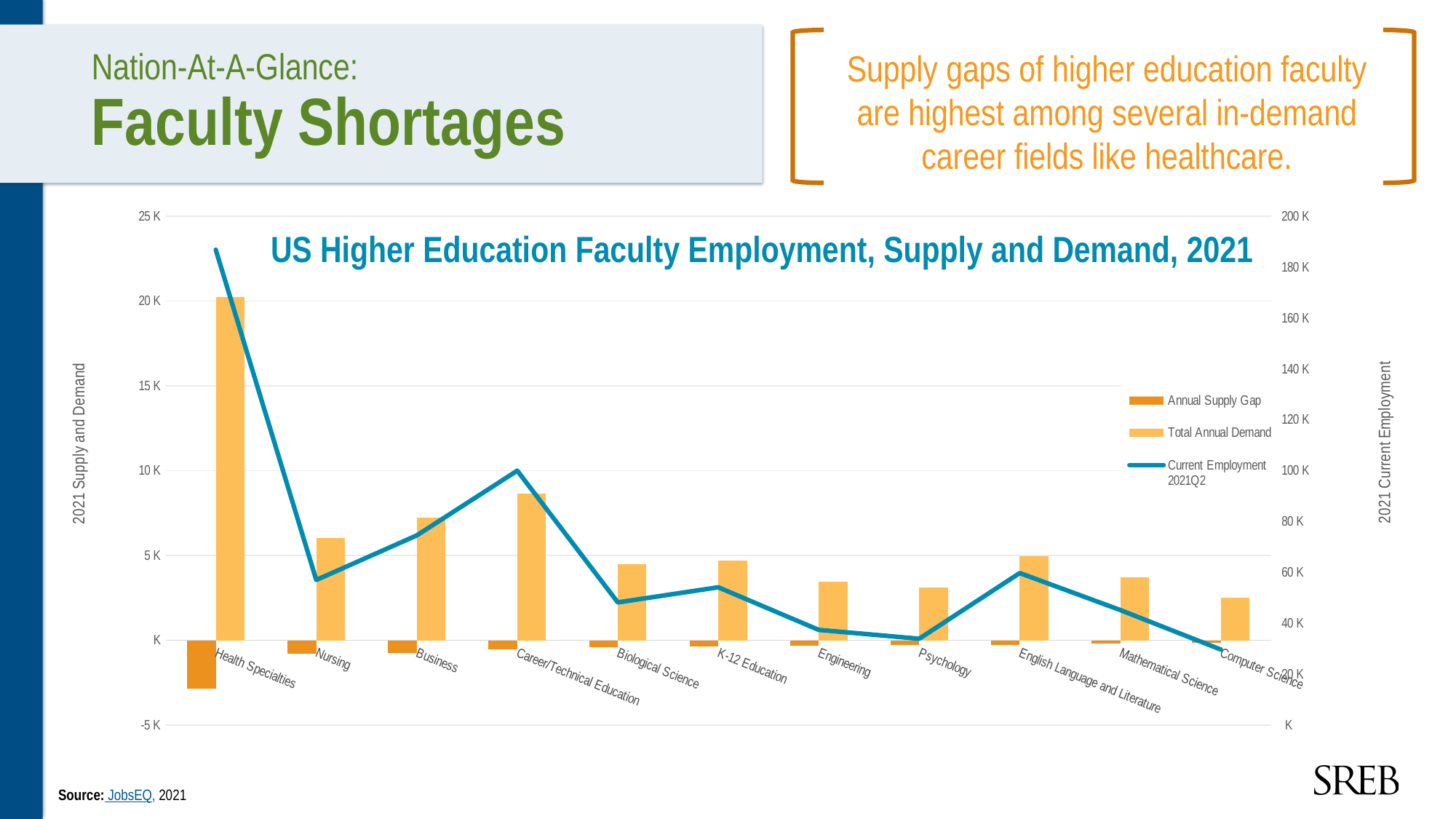
Which career field has the largest (most negative) Annual Supply Gap? Health Specialties Which has the larger Total Annual Demand, Business or Nursing? Business What kind of chart is this? Combined bar and line chart What is the title of the chart? US Higher Education Faculty Employment, Supply and Demand, 2021 Does the Current Employment 2021Q2 line rise or fall from Health Specialties to Nursing? fall How many career fields are shown along the x axis of the chart? 11 Is the Current Employment 2021Q2 for Health Specialties greater or less than 160 K? greater Is the Total Annual Demand for Career/Technical Education greater or less than 5 K? greater Is the Total Annual Demand for Health Specialties greater or less than 15 K? greater Which career field has the highest Total Annual Demand? Health Specialties Which career field has the lowest Total Annual Demand? Computer Science How many series does the chart legend list? 3